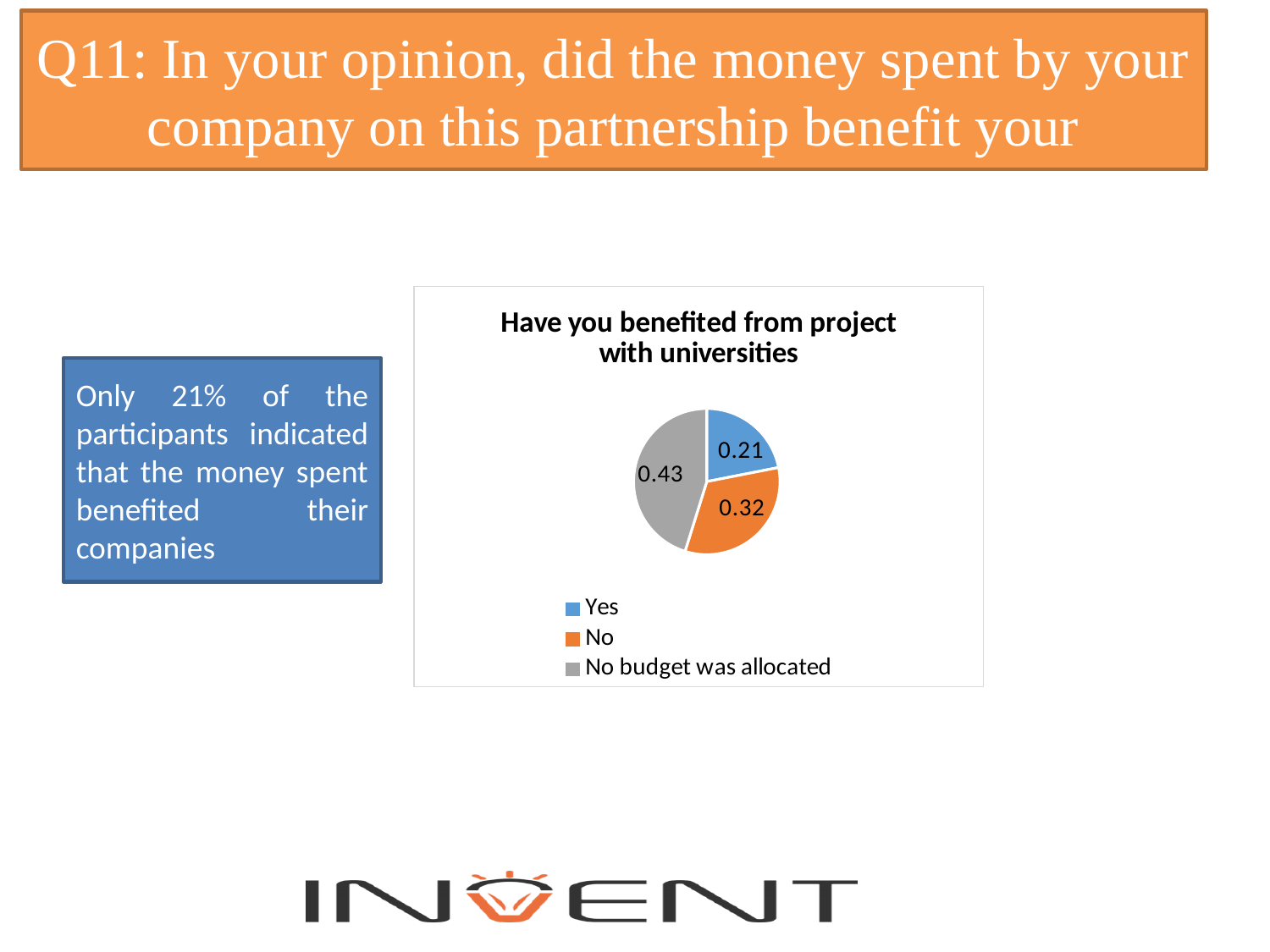
Which is larger, the No slice or the Yes slice? No What is the title of the chart? Have you benefited from project with universities What colour is the Yes slice? blue What is the value for the Yes slice? 0.21 Which category has the largest slice? No budget was allocated Which category has the smallest slice? Yes How many entries does the legend list? 3 What is the value for the No slice? 0.32 What is the difference between the No budget was allocated value and the Yes value? 0.22 How many slices does the pie chart have? 3 What type of chart is shown on the slide? pie chart What is the value for the No budget was allocated slice? 0.43